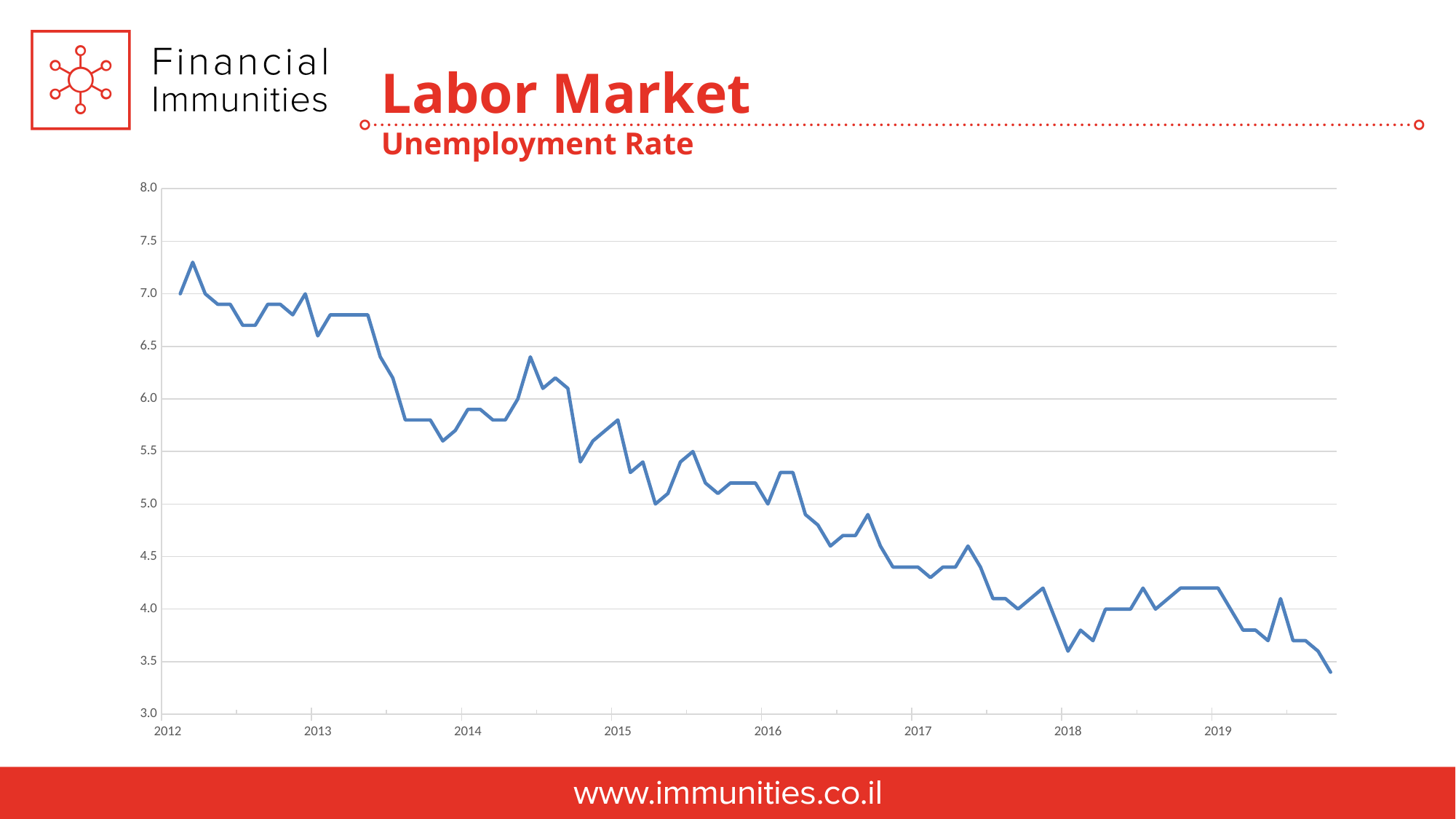
What is the title of the chart? Unemployment Rate Is the unemployment rate at the start of 2018 greater or less than 4.0? less Overall, does the unemployment rate rise or fall from 2012 to 2019? fall In which year does the unemployment rate reach its lowest point? 2019 Is the unemployment rate at the start of 2012 greater or less than 6.5? greater Is the unemployment rate at the end of 2019 greater or less than 4.0? less What kind of chart is shown on the slide? line chart In which year does the unemployment rate reach its highest point? 2012 Which is higher, the unemployment rate at the start of 2012 or at the end of 2019? start of 2012